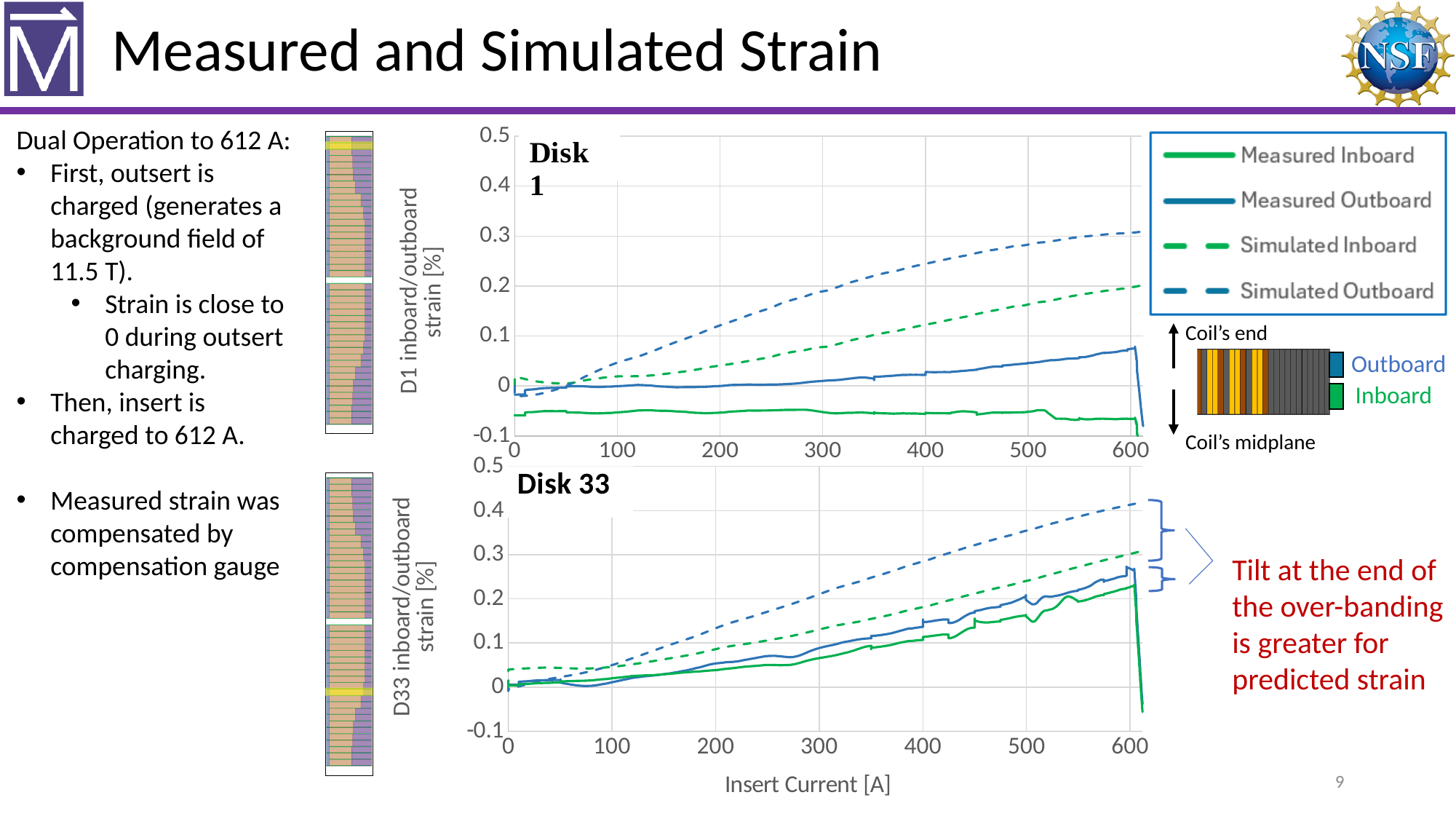
In the Disk 1 chart, is the Measured Outboard strain at 600 A greater or less than 0.1? less In the Disk 33 chart, is the Simulated Outboard strain at 600 A greater or less than 0.3? greater In the Disk 1 chart, is the Measured Inboard strain at 300 A greater or less than 0? less In the Disk 33 chart at 400 A, which is larger: the Simulated Outboard strain or the Measured Outboard strain? Simulated Outboard In the Disk 33 chart, does the Simulated Outboard strain rise or fall as insert current increases from 0 to 600 A? rise What kind of chart is the Disk 1 chart? line chart How many series does the legend list for the strain charts? 4 What is the x-axis label shared by the Disk 1 and Disk 33 charts? Insert Current [A] In the Disk 1 chart, which series has the lowest strain at 600 A? Measured Inboard What is the y-axis label of the Disk 33 chart? D33 inboard/outboard strain [%]